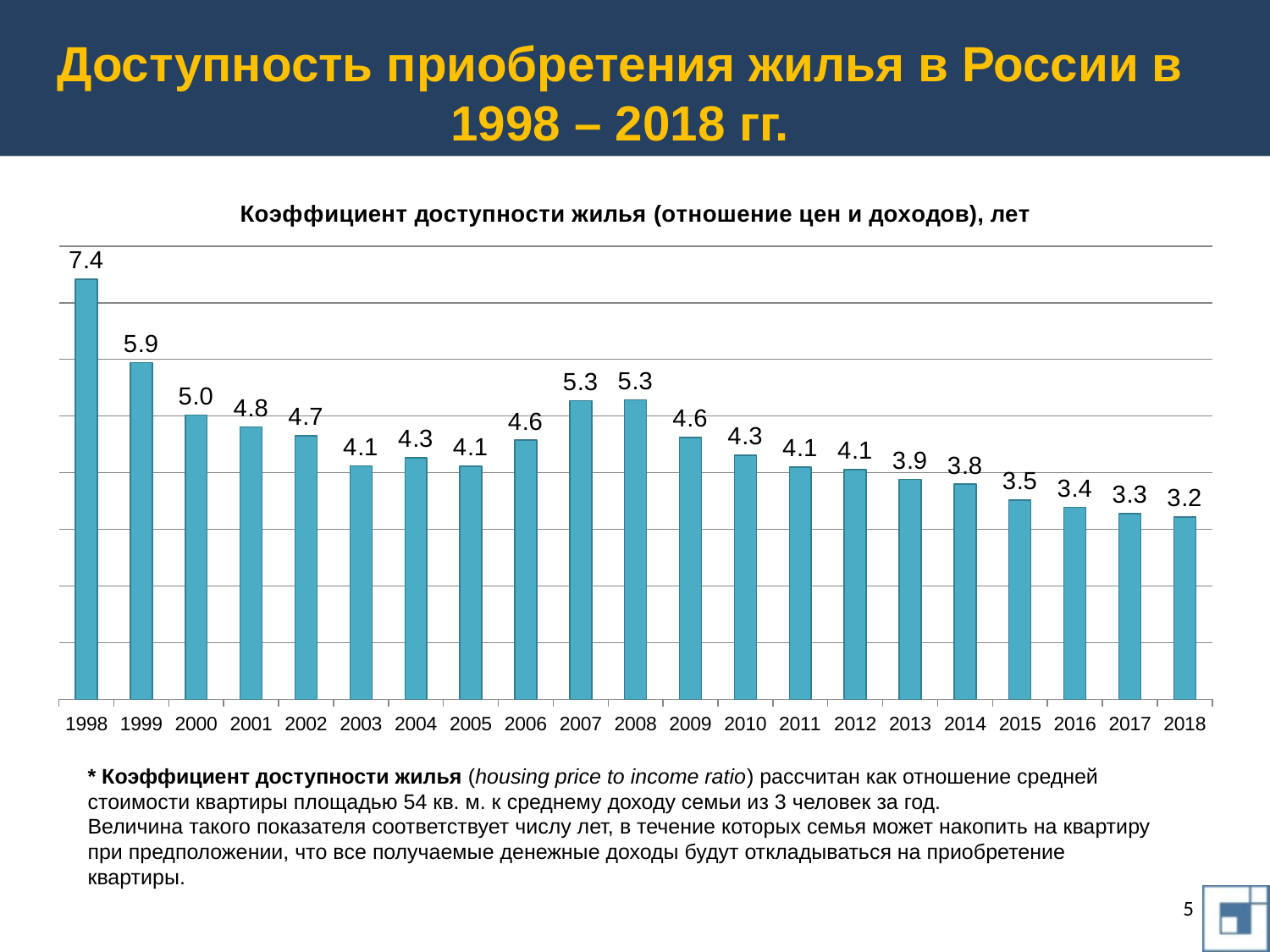
What is the difference between the values for 1999 and 2000? 0.9 Which year has the highest housing affordability coefficient? 1998 How many years are shown on the x axis? 21 What is the title of the chart? Коэффициент доступности жилья (отношение цен и доходов), лет What is the difference between the values for 1998 and 2018? 4.2 Do the values generally rise or fall from 1998 to 2018? Fall Which is larger, the value for 2006 or the value for 2007? 2007 What is the value shown for 2018? 3.2 Which year has the lowest housing affordability coefficient? 2018 What kind of chart is shown on the slide? Bar chart What is the housing affordability coefficient for 1998? 7.4 What is the value shown for 2008? 5.3